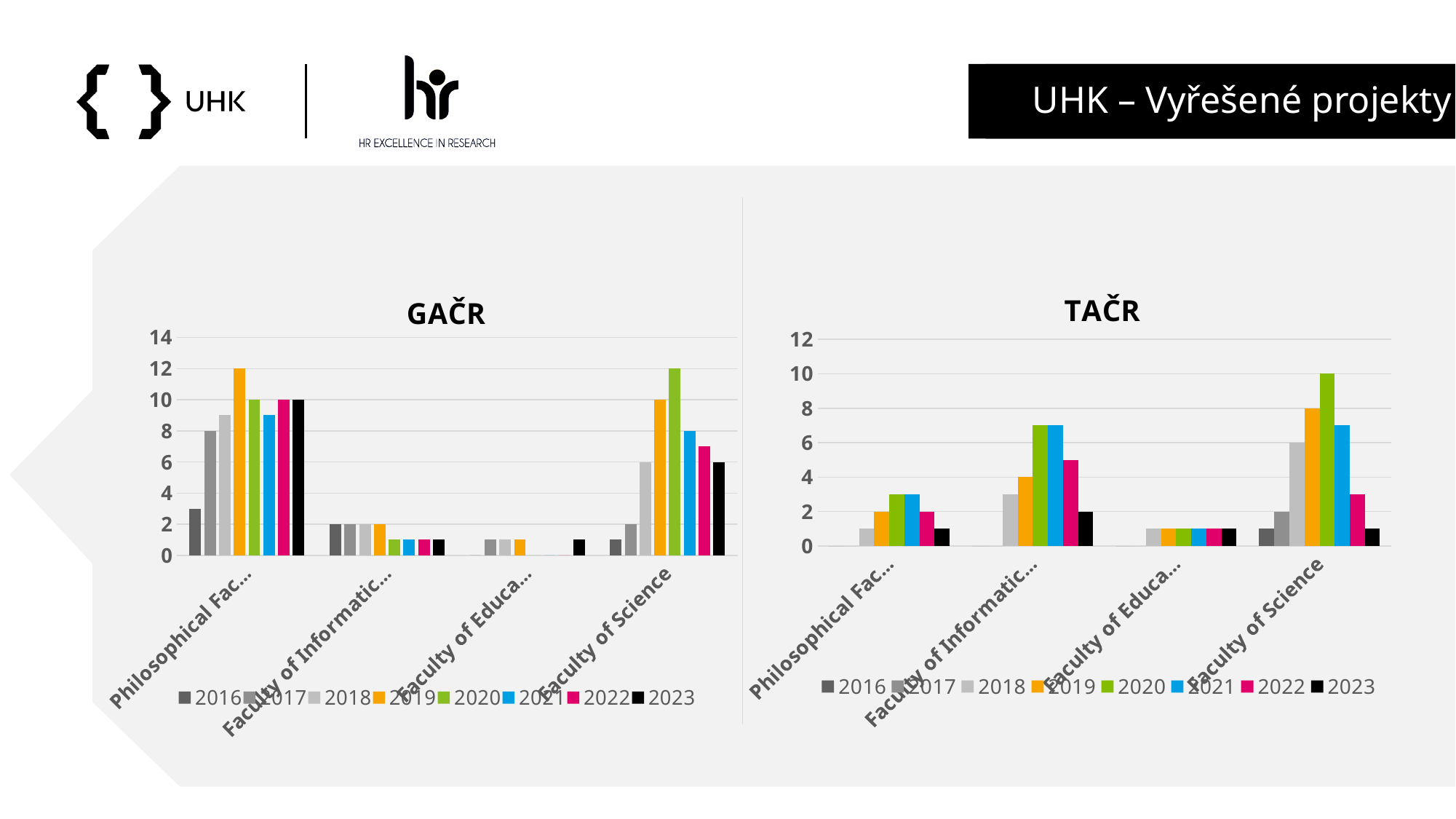
How many faculty categories are shown on the x axis of the GAČR chart? 4 In the GAČR chart, which year has the highest value for Faculty of Science? 2020 In the TAČR chart, is the 2023 value for the first category (Philosophical Fac...) greater or less than 2? less In the TAČR chart, is the 2020 value or the 2022 value larger for Faculty of Informatic...? 2020 In the GAČR chart, what is the value for Faculty of Science in 2020? 12 How many series does the legend of the TAČR chart list? 8 In the TAČR chart, what is the value for Faculty of Science in 2019? 8 What kind of chart is the GAČR chart? bar chart In the TAČR chart, what is the value for Faculty of Science in 2020? 10 In the GAČR chart, what is the difference between the 2020 and 2023 values for Faculty of Science? 6 In the TAČR chart, which year has the highest value for Faculty of Science? 2020 In the GAČR chart, what is the 2019 value for the first category (Philosophical Fac...)? 12